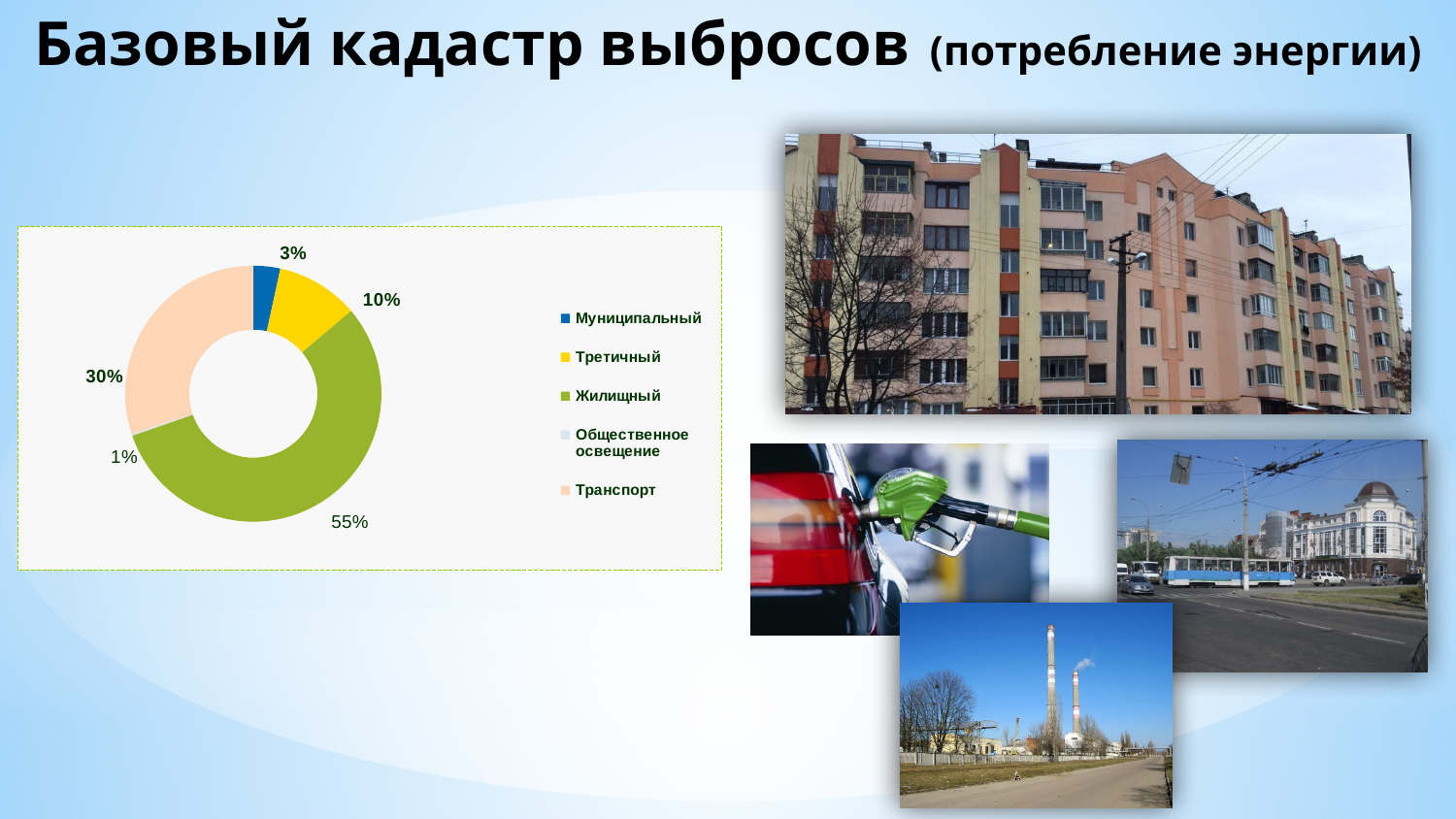
What percentage is shown for Транспорт? 30% Which colour represents Транспорт in the chart? light orange (peach) Which sector has the smallest share of the chart? Общественное освещение Which sector has the largest share of the chart? Жилищный What kind of chart is shown on the slide? doughnut chart What share of energy consumption does the Жилищный sector account for? 55% What is the difference in percentage points between Жилищный and Транспорт? 25 Which is larger, the share for Третичный or the share for Муниципальный? Третичный What percentage is shown for Третичный? 10% What percentage is shown for Общественное освещение? 1% How many sectors are shown in the chart? 5 What percentage is shown for Муниципальный? 3%